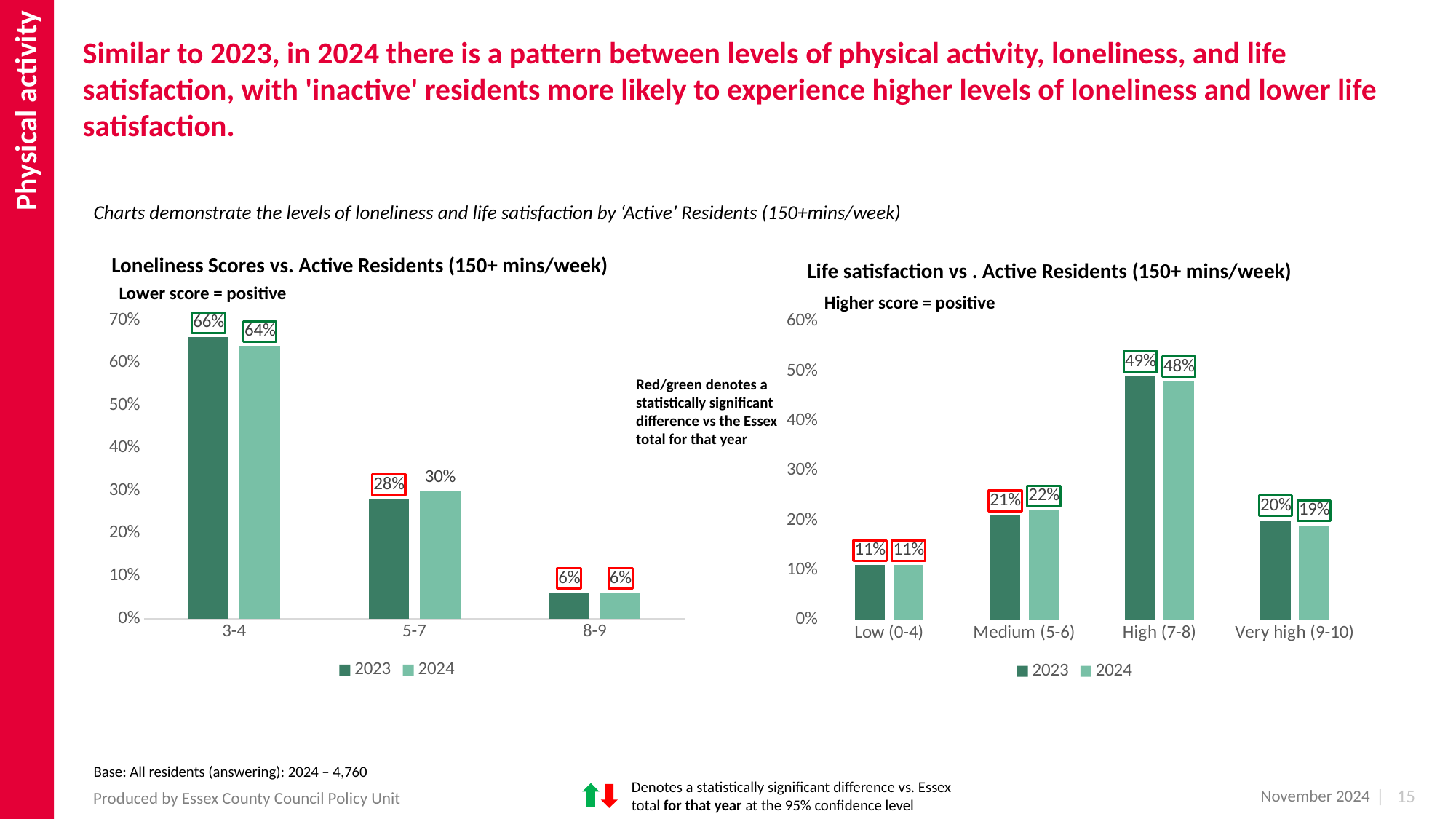
In the Life satisfaction vs. Active Residents chart, which category has the lowest 2024 value? Low (0-4) In the Loneliness Scores vs. Active Residents chart, what is the 2023 value for the 5-7 score group? 28% In the Loneliness Scores vs. Active Residents chart, what is the 2024 value for the 3-4 score group? 64% In the Life satisfaction vs. Active Residents chart, what is the 2023 value for High (7-8)? 49% In the Loneliness Scores vs. Active Residents chart, what is the difference between the 2023 and 2024 values for the 3-4 group? 2% In the Life satisfaction vs. Active Residents chart, is the 2024 value for Medium (5-6) larger or smaller than the 2023 value? larger In the Loneliness Scores vs. Active Residents chart, how many score groups are shown on the x axis? 3 How many series does the legend of the Life satisfaction vs. Active Residents chart list? 2 In the Life satisfaction vs. Active Residents chart, what is the 2024 value for Very high (9-10)? 19% What type of chart is the Loneliness Scores vs. Active Residents chart? Bar chart In the Life satisfaction vs. Active Residents chart, what is the difference between the 2023 values for High (7-8) and Medium (5-6)? 28% In the Loneliness Scores vs. Active Residents chart, which score group has the highest 2023 value? 3-4